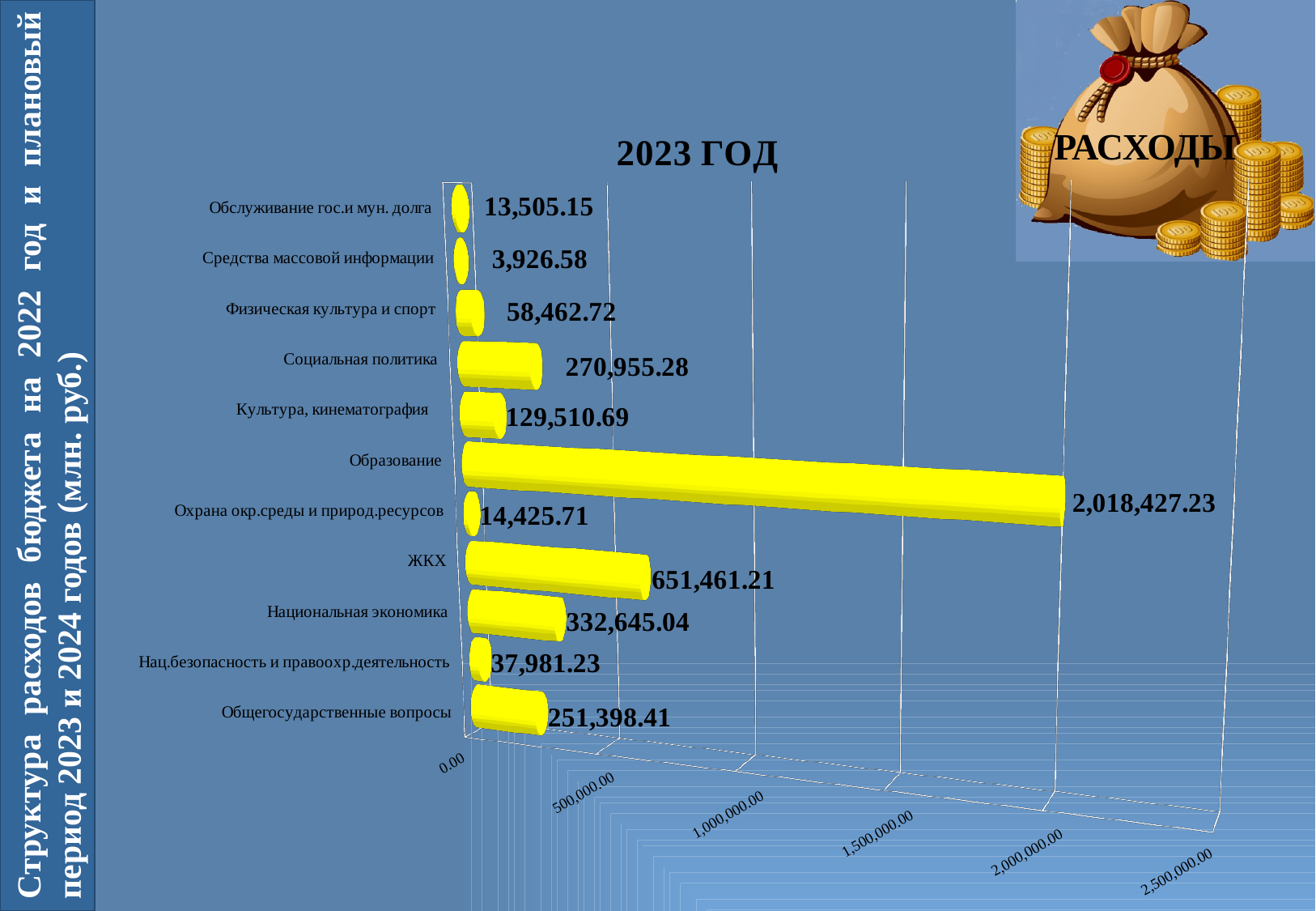
What is the difference between the values for ЖКХ and Национальная экономика in the 2023 ГОД chart? 318,816.17 Which is larger in the 2023 ГОД chart: Национальная экономика or Общегосударственные вопросы? Национальная экономика What is the title of the chart on the slide? 2023 ГОД What is the value for Социальная политика in the 2023 ГОД chart? 270,955.28 What is the value for ЖКХ in the 2023 ГОД chart? 651,461.21 What is the value for Образование in the 2023 ГОД chart? 2,018,427.23 What is the value for Средства массовой информации in the 2023 ГОД chart? 3,926.58 Which category has the lowest value in the 2023 ГОД chart? Средства массовой информации What kind of chart is the 2023 ГОД chart? bar chart Is the value for Образование in the 2023 ГОД chart greater or less than 2,000,000.00? greater Which category has the highest value in the 2023 ГОД chart? Образование How many categories are shown in the 2023 ГОД chart? 11